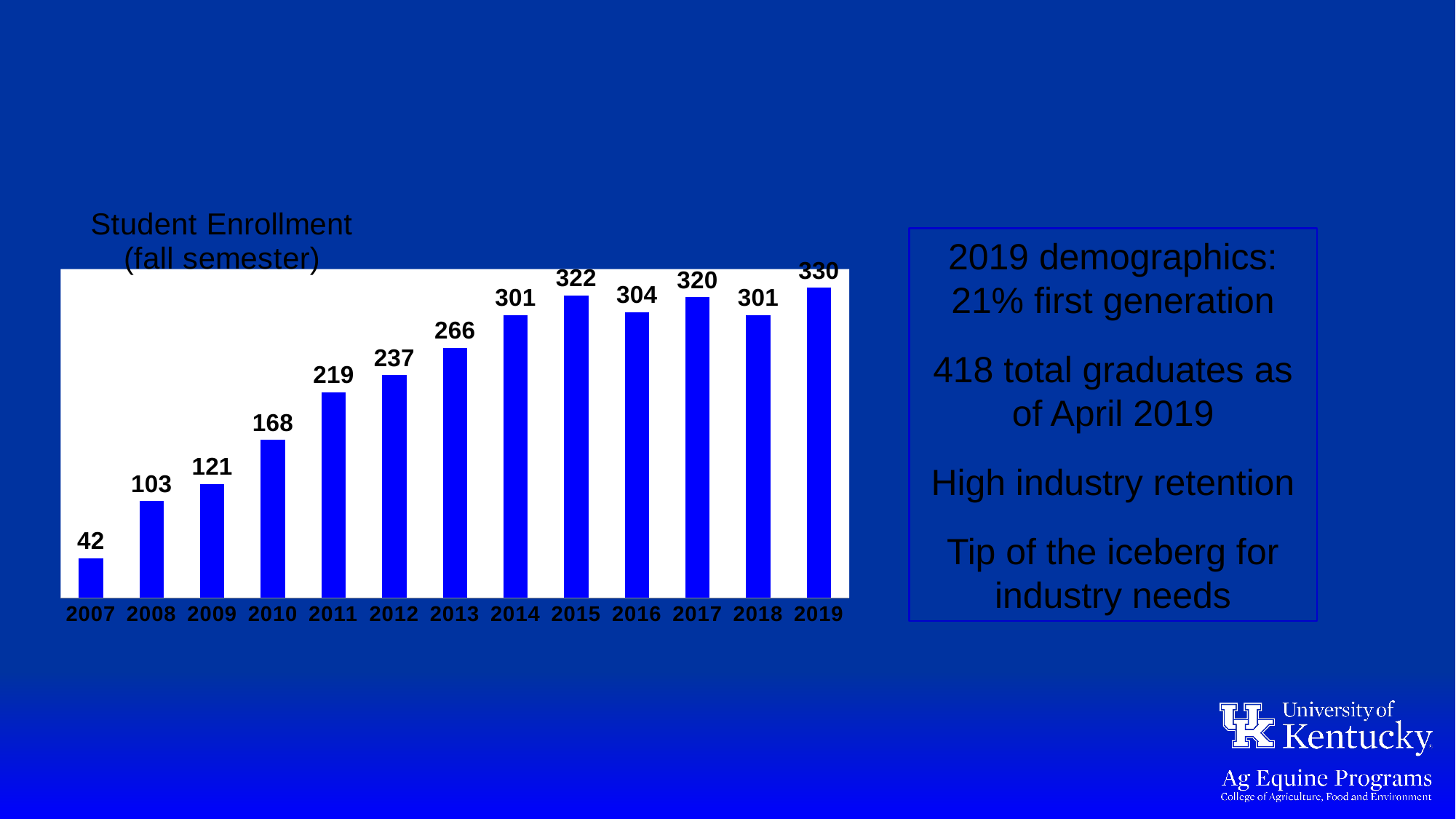
What is the overall trend in student enrollment from 2007 to 2019? Rising How many years are shown on the x axis of the chart? 13 What is the difference in enrollment between 2019 and 2007? 288 How much higher was enrollment in 2015 than in 2016? 18 What type of chart is used to show student enrollment? Bar chart Which year had the highest student enrollment? 2019 What is the title of the chart? Student Enrollment (fall semester) Which year had higher enrollment, 2010 or 2011? 2011 What was the student enrollment in fall 2013? 266 Which year had the lowest student enrollment? 2007 What was the student enrollment in fall 2018? 301 What was the student enrollment in fall 2007? 42